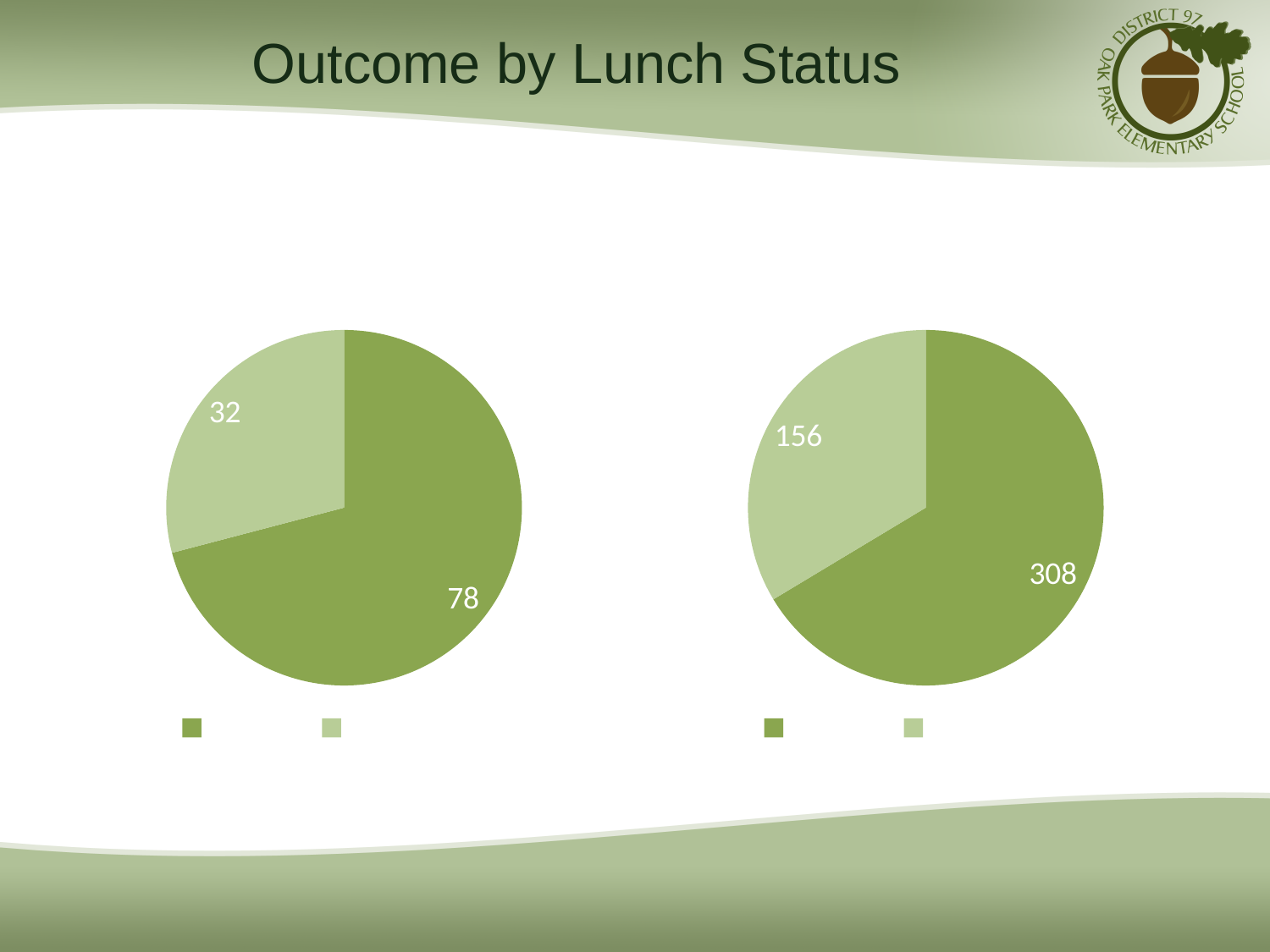
What is the total of the two slices in the right pie chart? 464 In the right pie chart, what is the value of the larger, darker green slice? 308 In the left pie chart, what is the difference between the two slice values? 46 What is the total of the two slices in the left pie chart? 110 In the left pie chart, what is the value of the larger, darker green slice? 78 How many slices does the left pie chart have? 2 What kind of chart is the chart on the left of the slide? pie chart What is the title of the slide containing the two pie charts? Outcome by Lunch Status How many slices does the right pie chart have? 2 In the left pie chart, what is the value of the smaller, lighter green slice? 32 In the right pie chart, what is the value of the smaller, lighter green slice? 156 In the right pie chart, what is the difference between the two slice values? 152